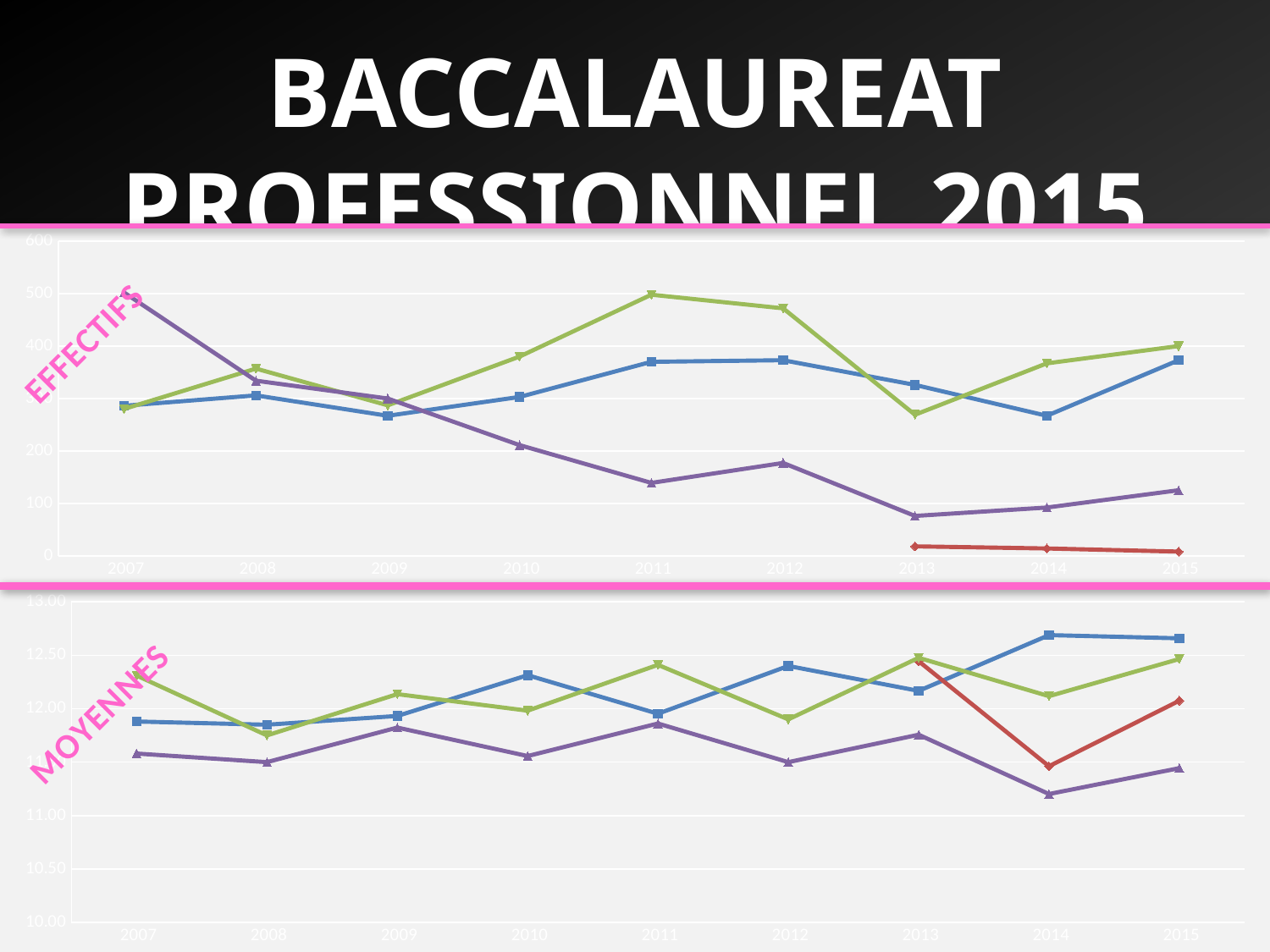
In the MOYENNES chart, is the value of the red line in 2014 greater or less than 12.00? less In the MOYENNES chart, is the value of the blue line in 2014 greater or less than 12.50? greater In the MOYENNES chart, is the value of the purple line in 2014 greater or less than 11.50? less What is the pink label written on the bottom chart? MOYENNES In the EFFECTIFS chart, which line has the highest value in 2011? the green line How many years are shown on the x axis of the EFFECTIFS chart? 9 What kind of chart is the top chart labelled EFFECTIFS? line chart In the EFFECTIFS chart, does the purple line rise or fall from 2007 to 2011? fall In the MOYENNES chart, which line has the lowest value in 2015? the purple line